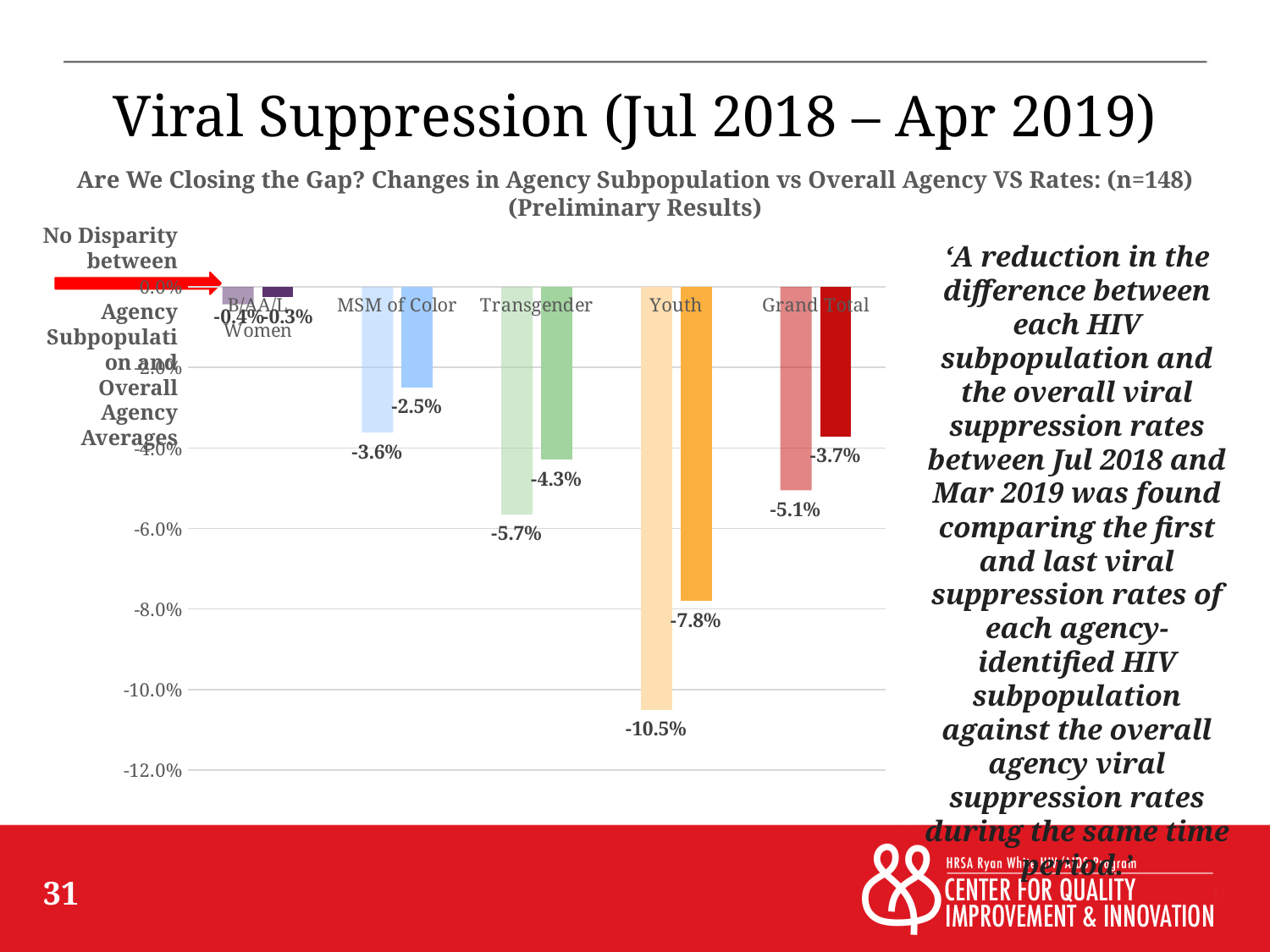
What is the difference between the two bars for Youth (-10.5% and -7.8%)? 2.7% Is the first (lighter) bar for Youth greater or less than -10.0%? less What is the subtitle of the chart above the plot area? Are We Closing the Gap? Changes in Agency Subpopulation vs Overall Agency VS Rates: (n=148) (Preliminary Results) Which category has the lowest (most negative) value in the chart? Youth What is the value of the first (lighter) bar for Youth? -10.5% What is the value of the first (lighter) bar for MSM of Color? -3.6% What is the value of the second (darker) bar for Youth? -7.8% What is the value of the first (lighter) bar for Grand Total? -5.1% Which is more negative: the first bar for Transgender or the first bar for Grand Total? Transgender How many categories are shown on the x axis of the chart? 5 What is the value of the second (darker) bar for Transgender? -4.3% What type of chart is shown on the slide? bar chart